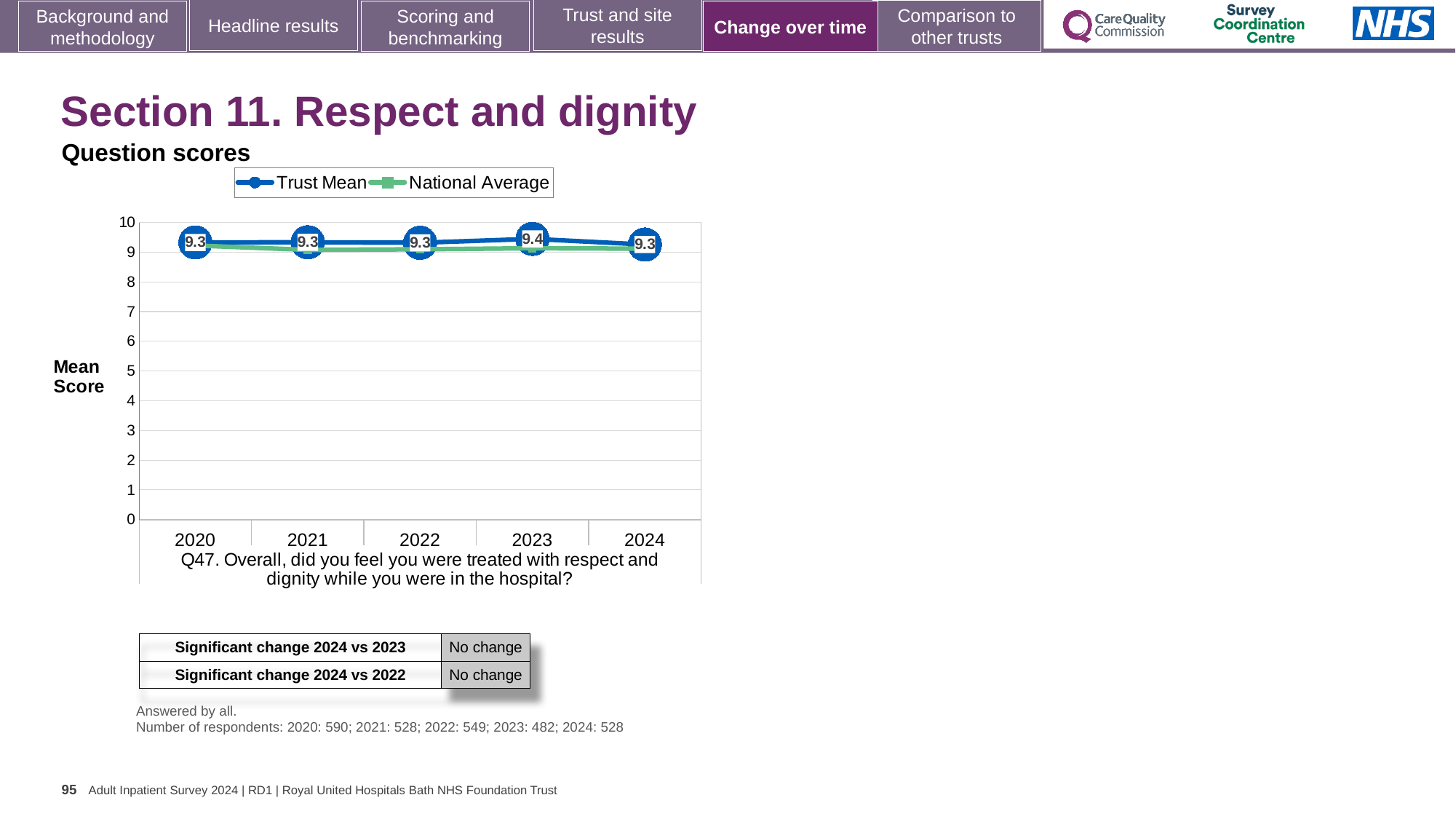
What kind of chart is shown on the slide? Line chart What are the two series named in the chart legend? Trust Mean and National Average How many series does the chart legend list? 2 Is the National Average value for 2022 greater or less than 8? greater Which year has the larger Trust Mean score, 2023 or 2024? 2023 How many years are shown on the x axis of the chart? 5 What is the Trust Mean score for 2023? 9.4 What is the difference between the Trust Mean score in 2023 and in 2022? 0.1 What is the Trust Mean score for 2024? 9.3 In which year is the Trust Mean score highest? 2023 What is the Trust Mean score for 2020? 9.3 Does the Trust Mean score rise, fall, or stay roughly flat from 2020 to 2024? Roughly flat